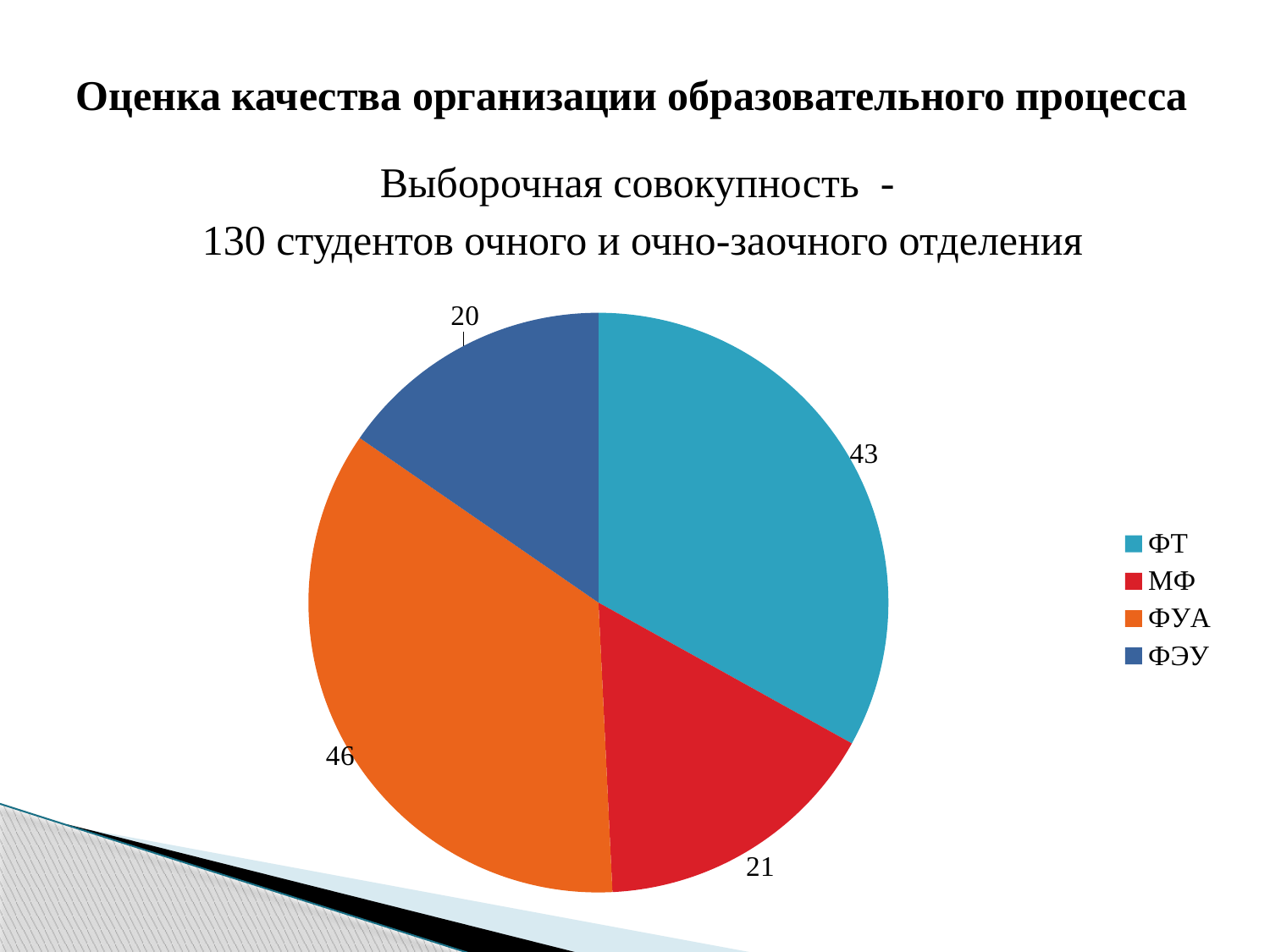
What is the difference between the values for ФУА and ФТ? 3 What value is shown for the ФТ slice of the pie chart? 43 What is the difference between the values for МФ and ФЭУ? 1 What colour is the ФУА slice in the pie chart? Orange What value is shown for the ФУА slice of the pie chart? 46 What value is shown for the ФЭУ slice of the pie chart? 20 Which category has the smallest slice in the pie chart? ФЭУ What kind of chart is shown on the slide? Pie chart What value is shown for the МФ slice of the pie chart? 21 Which is larger, the value for ФТ or the value for МФ? ФТ Which category has the largest slice in the pie chart? ФУА How many categories does the pie chart show? 4